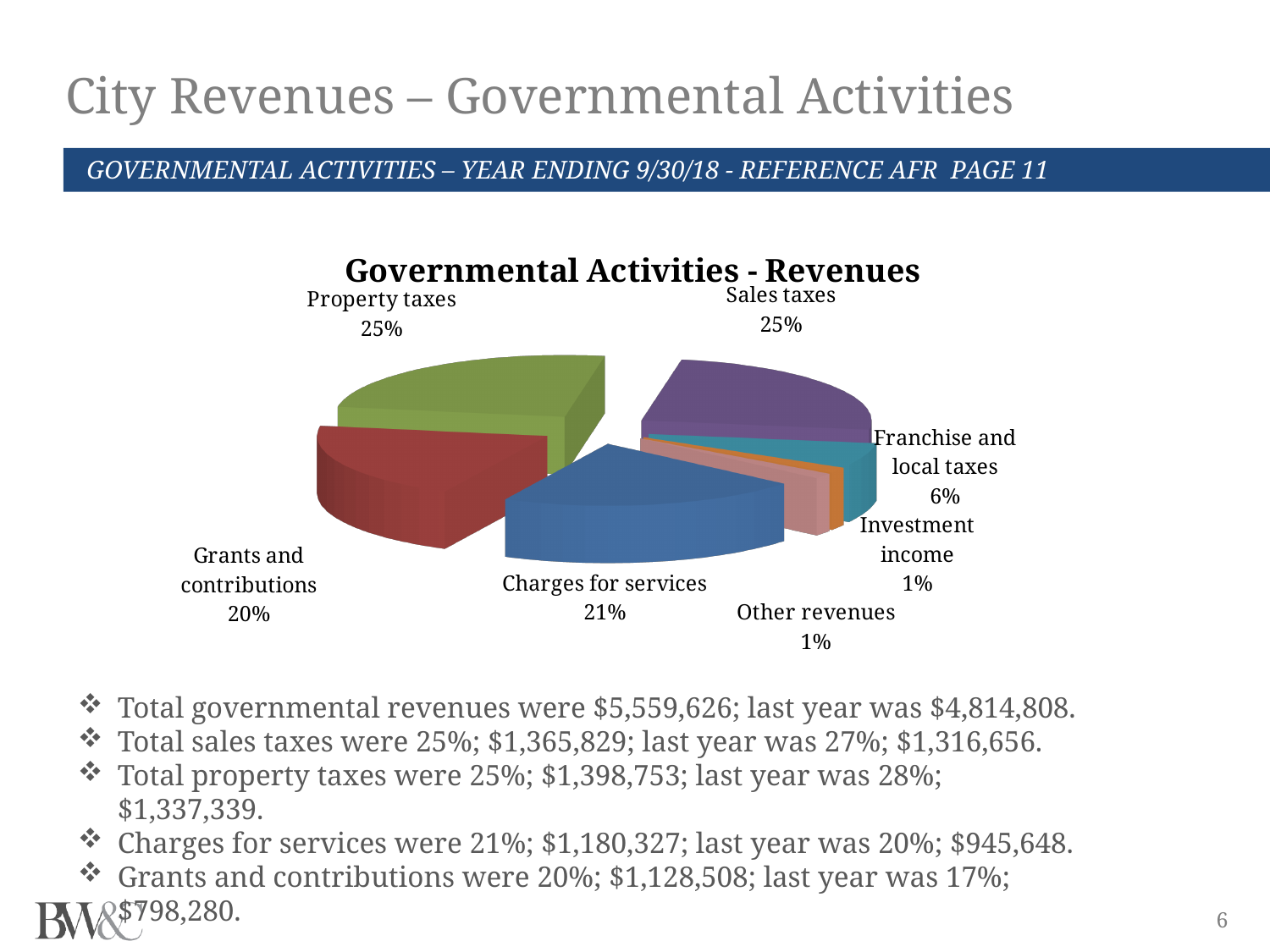
What is the difference in percentage points between Sales taxes and Charges for services? 4 What share of the pie does Property taxes represent? 25% What percentage is shown for Franchise and local taxes? 6% Which is larger, Charges for services or Grants and contributions? Charges for services What percentage is shown for Grants and contributions? 20% What is the difference in percentage points between Franchise and local taxes and Investment income? 5 What kind of chart is shown on the slide? Pie chart What percentage is shown for Investment income? 1% What share of the pie does Charges for services represent? 21% Which is larger, Sales taxes or Franchise and local taxes? Sales taxes How many slices does the pie chart have? 7 What percentage is shown for Other revenues? 1%